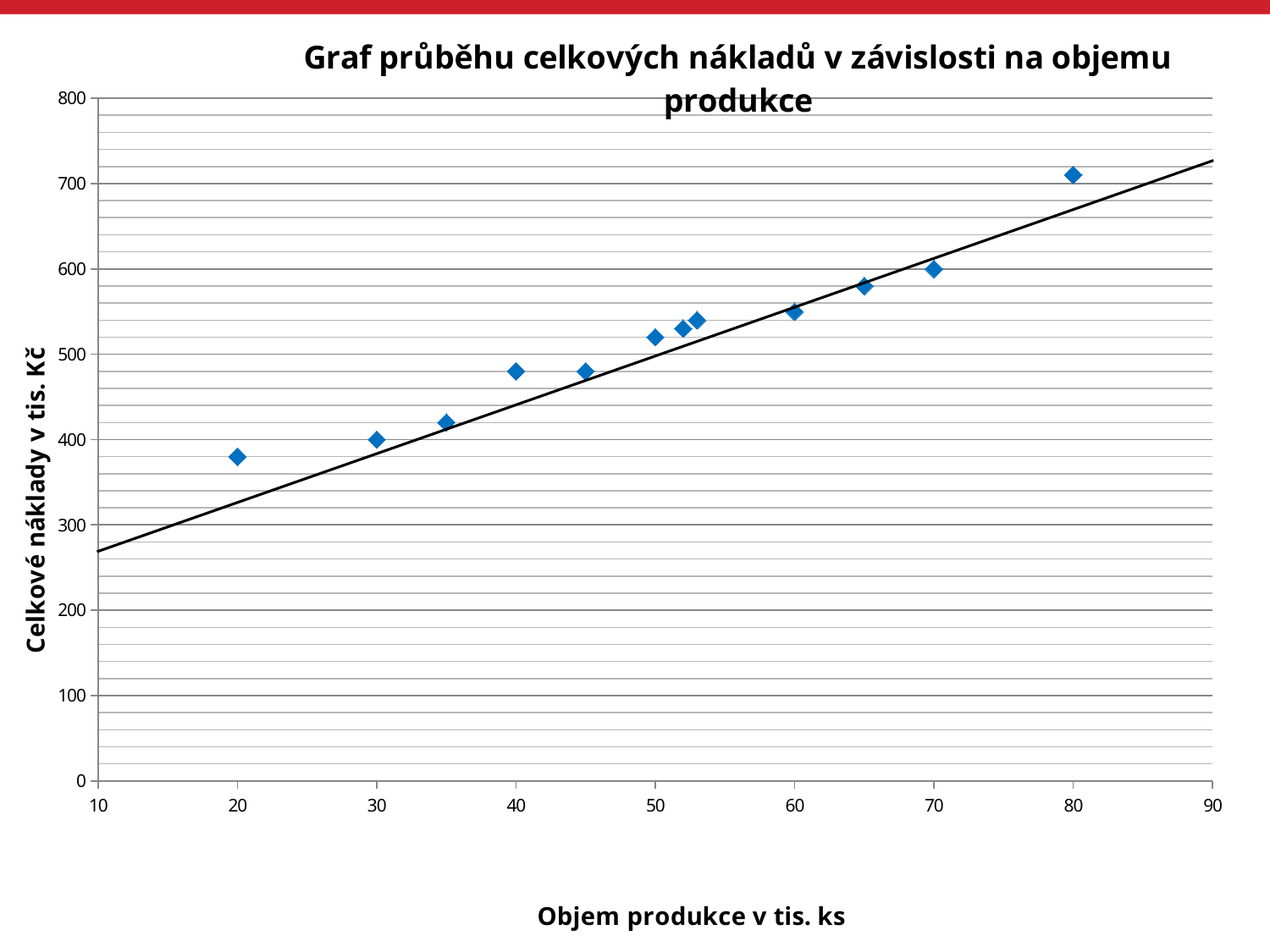
Do the total costs rise or fall as production volume increases along the x axis? rise What is the title of the chart? Graf průběhu celkových nákladů v závislosti na objemu produkce At which production volume (x value) is the plotted total cost highest? 80 How many data points are plotted on the chart? 12 Is the total cost at a production volume of 30 greater or less than 500? less Is the total cost at a production volume of 80 greater or less than 700? greater What is the label of the vertical axis? Celkové náklady v tis. Kč Is the total cost at a production volume of 20 greater or less than 400? less At which production volume (x value) is the plotted total cost lowest? 20 Which has the higher total cost: the point at production volume 70 or the point at production volume 40? 70 What kind of chart is shown on the slide? scatter chart